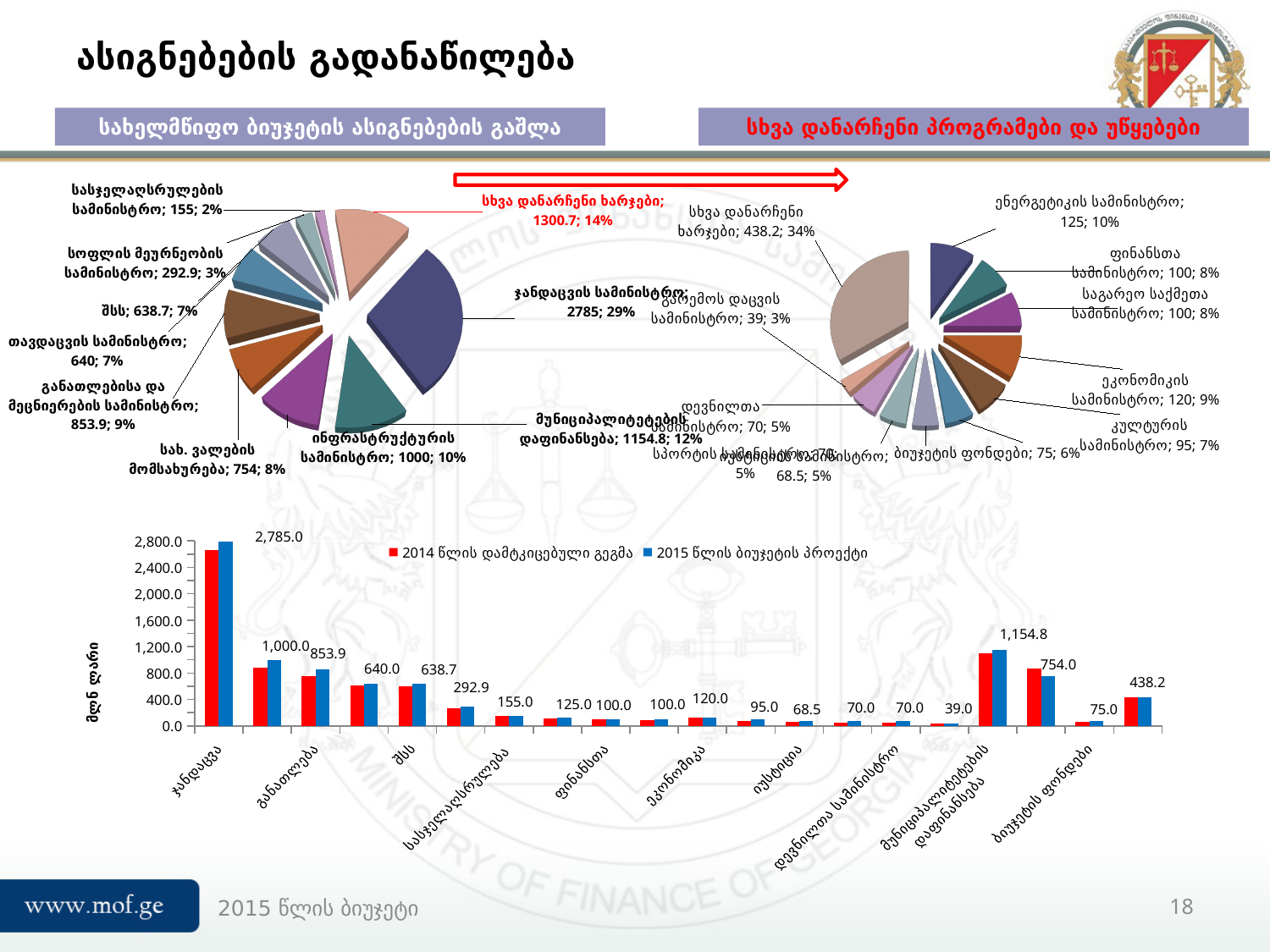
In the bottom bar chart, what is the labelled value for ჯანდაცვა? 2,785.0 In the right pie chart, which category has the smallest share? გარემოს დაცვის სამინისტრო In the right pie chart, what is the share for კულტურის სამინისტრო? 7% What type of chart is at the bottom of the slide? bar chart In the left pie chart, what is the difference between the values for თავდაცვის სამინისტრო and შსს? 1.3 In the left pie chart, what value and share are shown for ჯანდაცვის სამინისტრო? 2785; 29% In the left pie chart, which category has the smallest share? სასჯელაღსრულების სამინისტრო In the right pie chart, what value and share are shown for სხვა დანარჩენი ხარჯები? 438.2; 34% In the bottom bar chart, is the 2015 value for განათლება greater or less than 400.0? greater How many series does the legend of the bottom bar chart list? 2 In the right pie chart, which is larger: ენერგეტიკის სამინისტრო or ეკონომიკის სამინისტრო? ენერგეტიკის სამინისტრო In the left pie chart, what share does სხვა დანარჩენი ხარჯები have? 14%